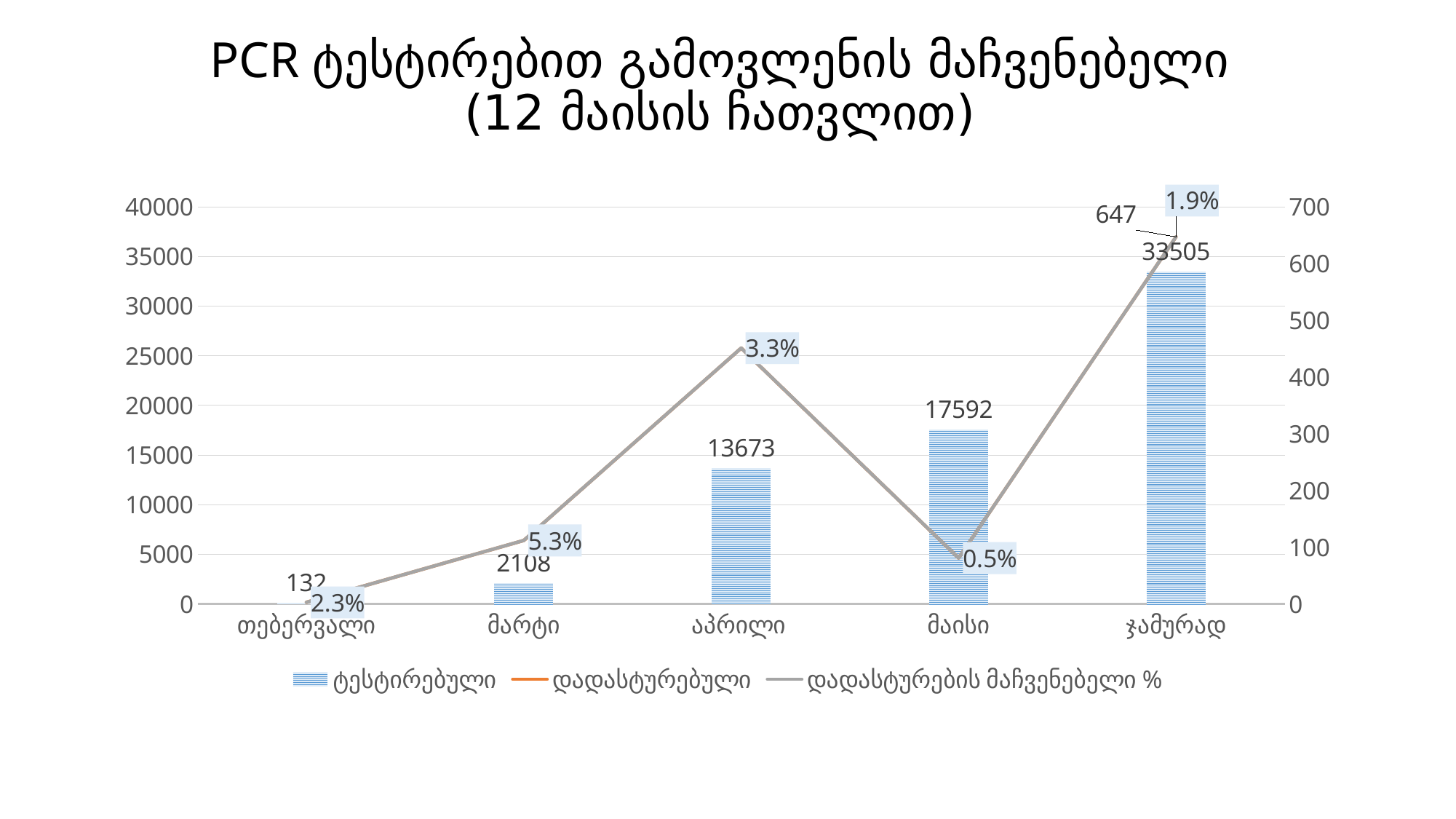
Which category has the lowest დადასტურების მაჩვენებელი %? მაისი How many categories are shown on the x axis? 5 What is the value of ტესტირებული for მარტი? 2108 What is the difference between the ტესტირებული values for მაისი and აპრილი? 3919 What is the დადასტურების მაჩვენებელი % for მაისი? 0.5% What is the value of ტესტირებული for მაისი? 17592 What is the დადასტურების მაჩვენებელი % for მარტი? 5.3% What is the value of დადასტურებული for ჯამურად? 647 What is the value of ტესტირებული for აპრილი? 13673 How many series does the legend list? 3 What is the value of ტესტირებული for ჯამურად? 33505 Which category has the highest დადასტურების მაჩვენებელი %? მარტი